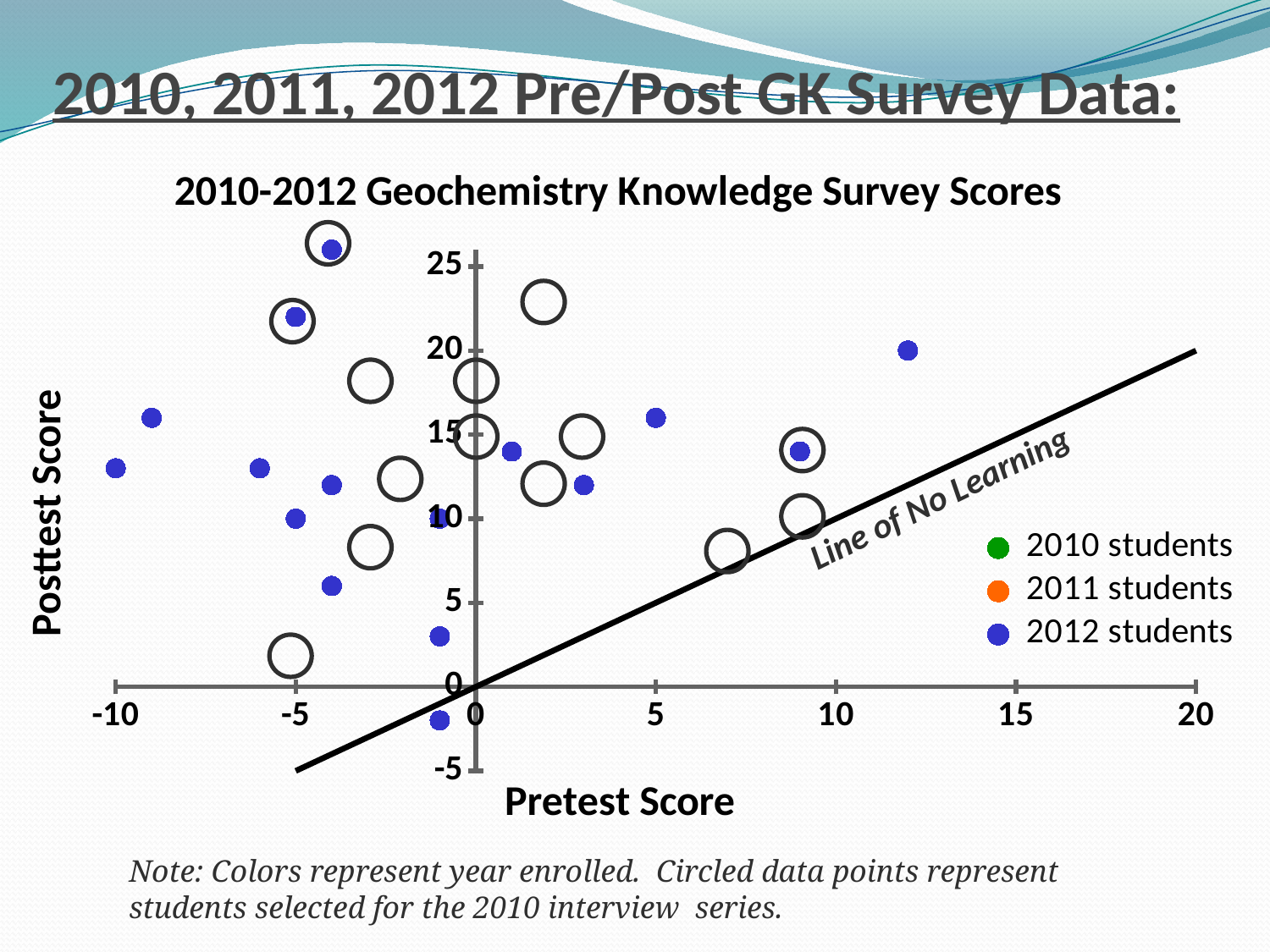
Is the posttest score of the point with the lowest pretest score (at -10) greater or less than 10? greater What kind of chart is shown on the slide? Scatter chart How many series does the legend list? 3 Is the lowest posttest score plotted on the chart greater or less than 0? less What is the title of the chart? 2010-2012 Geochemistry Knowledge Survey Scores What does the diagonal black line on the chart represent, according to its label? Line of No Learning Is the posttest score of the point with the highest pretest score greater or less than 15? greater Which has the higher posttest score: the point with the highest pretest score or the point with the lowest pretest score? The point with the highest pretest score